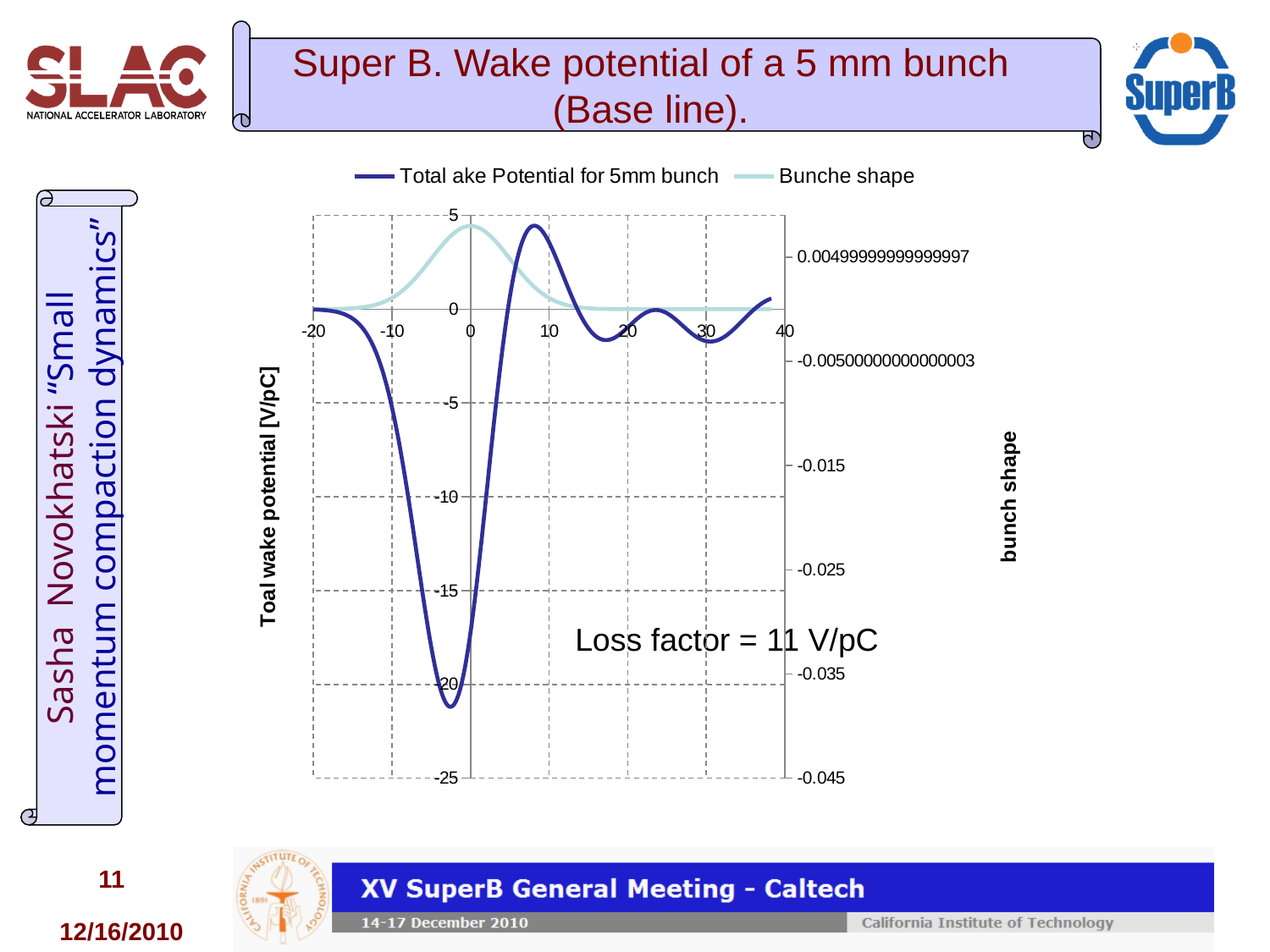
Which series reaches the lowest value on the chart? Total ake Potential for 5mm bunch How many series does the chart legend list? 2 What is the title of the left vertical axis of the chart? Toal wake potential [V/pC] Is the lowest value of the Total wake potential curve greater or less than -25? greater Is the peak of the Total wake potential curve near x = 10 greater or less than 0? greater What are the two series named in the chart legend? Total ake Potential for 5mm bunch; Bunche shape What loss factor is stated on the chart? 11 V/pC Does the Bunche shape curve rise or fall as x goes from 0 to 10? fall What kind of chart is shown on the slide? line chart Is the Total wake potential at x = 20 greater or less than 0? less Does the Bunche shape curve rise or fall as x goes from -20 to 0? rise